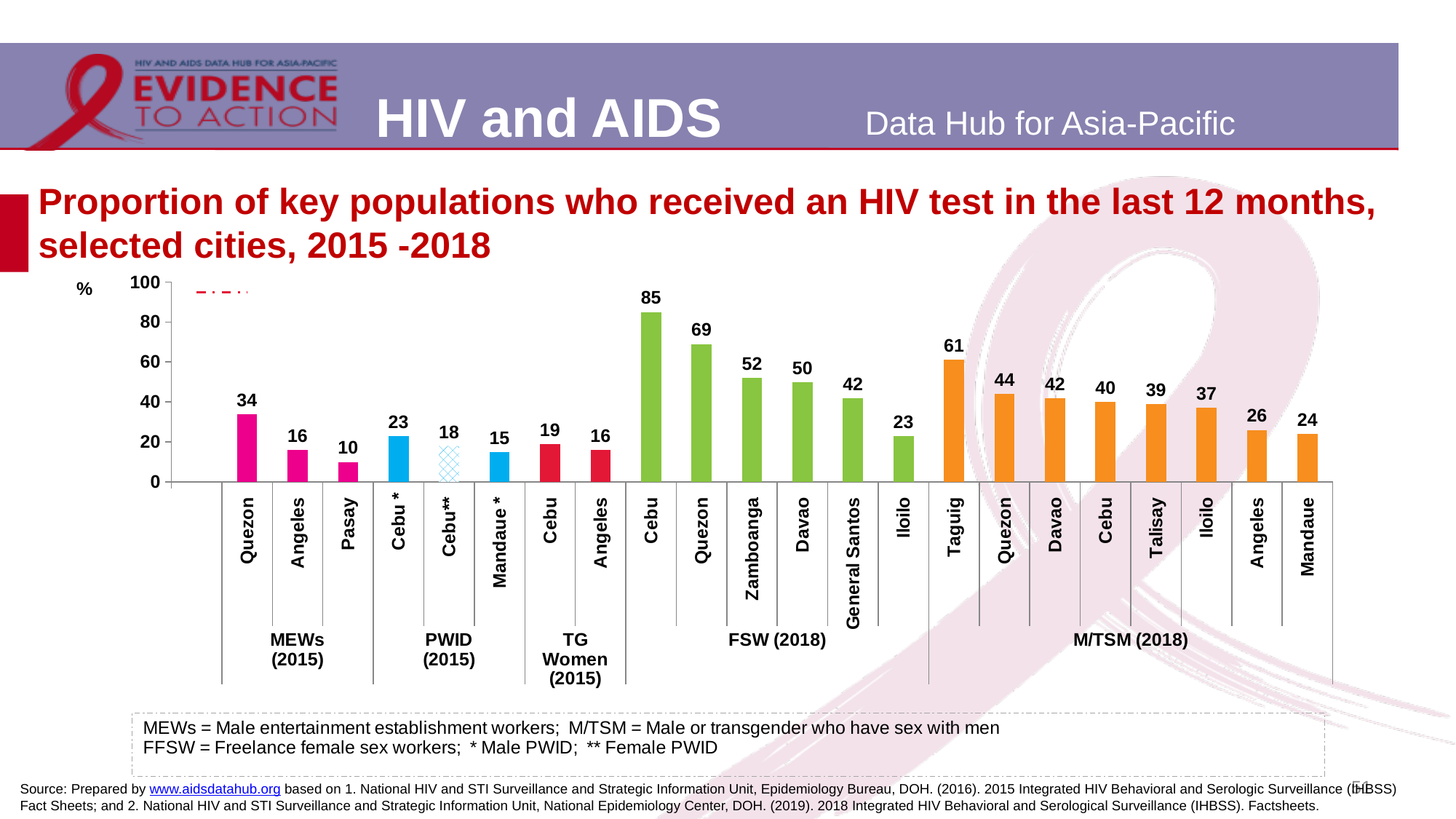
What is the value for Mandaue * in the PWID (2015) group? 15 What is the value for Taguig in the M/TSM (2018) group? 61 What is the difference between Quezon and Angeles in the MEWs (2015) group? 18 How many cities are shown in the M/TSM (2018) group? 8 What kind of chart is shown on the slide? Bar chart Which city has the highest value in the FSW (2018) group? Cebu How many bars are plotted in the chart in total? 22 What is the value for Pasay in the MEWs (2015) group? 10 Which city has the lowest value in the M/TSM (2018) group? Mandaue What is the difference between Cebu and Iloilo in the FSW (2018) group? 62 What is the value for Cebu in the FSW (2018) group? 85 Which is larger: Quezon in the FSW (2018) group or Quezon in the M/TSM (2018) group? Quezon in the FSW (2018) group